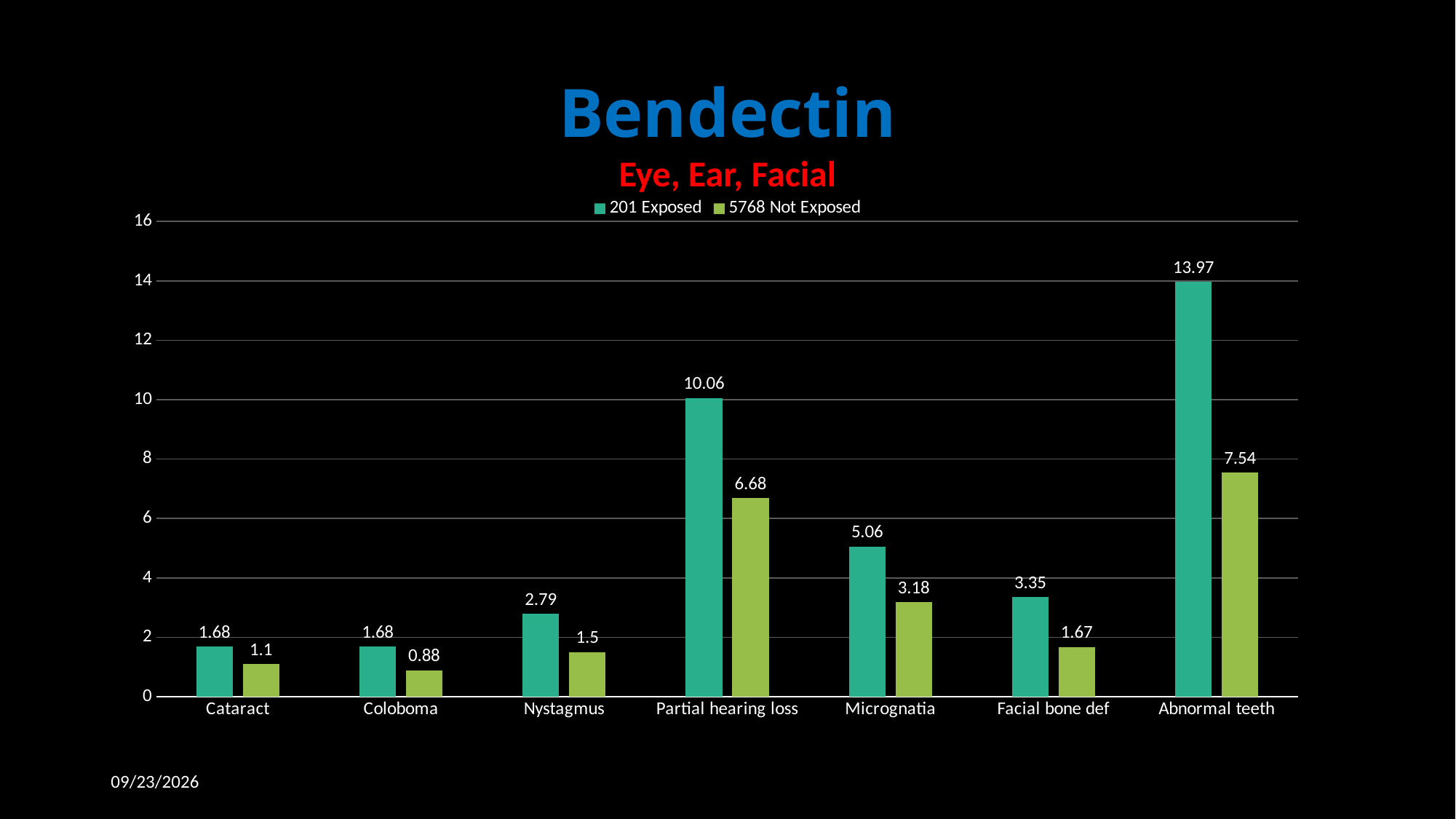
What is the value for 5768 Not Exposed for Abnormal teeth? 7.54 How many series does the legend list? 2 Is the value for 201 Exposed for Abnormal teeth greater or less than 12? greater What kind of chart is shown on the slide? Bar chart What is the value for 5768 Not Exposed for Coloboma? 0.88 What is the difference between the 201 Exposed and 5768 Not Exposed values for Micrognatia? 1.88 Which category has the highest value for 201 Exposed? Abnormal teeth Which category has the lowest value for 5768 Not Exposed? Coloboma Which is larger for Facial bone def: the 201 Exposed value or the 5768 Not Exposed value? 201 Exposed What is the red subtitle of the chart? Eye, Ear, Facial How many categories are shown on the x axis? 7 What is the value for 201 Exposed for Partial hearing loss? 10.06